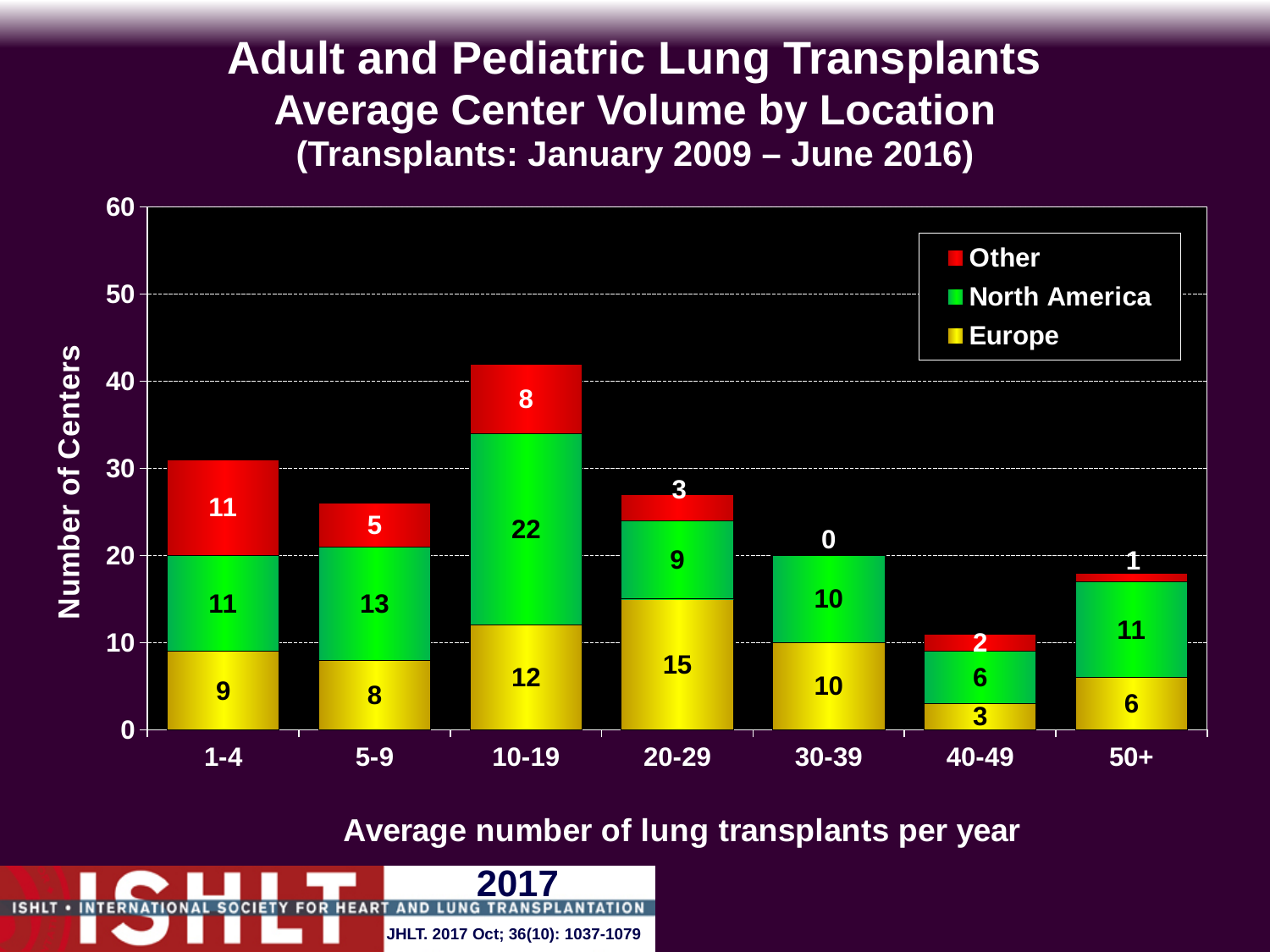
What kind of chart is shown on the slide? Stacked bar chart What is the total number of centers for the 40-49 category? 11 Which is larger, the Other value for 1-4 or the Other value for 10-19? 1-4 What is the Other value for the 30-39 category? 0 How many categories are shown on the x axis? 7 Which category has the lowest North America value? 40-49 What is the Europe value for the 20-29 category? 15 What is the North America value for the 10-19 category? 22 Which category has the highest Europe value? 20-29 What is the total number of centers for the 10-19 category? 42 How many series does the legend list? 3 What is the difference between the North America values for 10-19 and 5-9? 9